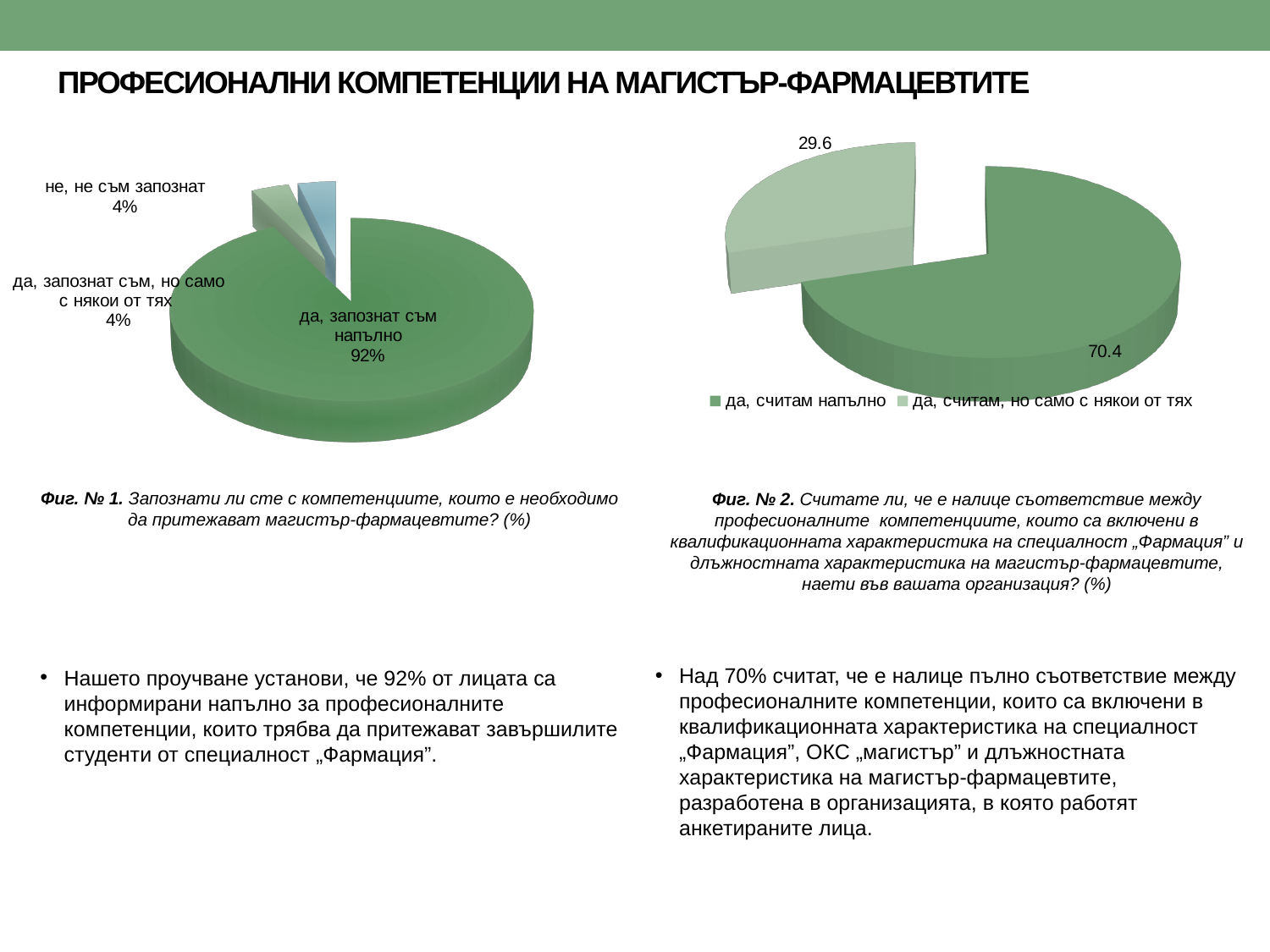
In the left pie chart (Фиг. № 1), is the slice for "да, запознат съм напълно" larger or smaller than the slice for "не, не съм запознат"? larger In the left pie chart (Фиг. № 1), what share is labelled for "да, запознат съм, но само с някои от тях"? 4% What type of chart is shown on the left (Фиг. № 1)? Pie chart In the right pie chart (Фиг. № 2), what is the difference between the values for "да, считам напълно" and "да, считам, но само с някои от тях"? 40.8 In the left pie chart (Фиг. № 1), what share is labelled for "не, не съм запознат"? 4% In the right pie chart (Фиг. № 2), which category has the smaller slice? да, считам, но само с някои от тях In the right pie chart (Фиг. № 2), what value is labelled for "да, считам напълно"? 70.4 How many slices does the left pie chart (Фиг. № 1) have? 3 In the left pie chart (Фиг. № 1), what share is labelled for "да, запознат съм напълно"? 92% How many entries does the legend of the right pie chart (Фиг. № 2) list? 2 In the right pie chart (Фиг. № 2), what value is labelled for "да, считам, но само с някои от тях"? 29.6 In the left pie chart (Фиг. № 1), which category has the largest slice? да, запознат съм напълно